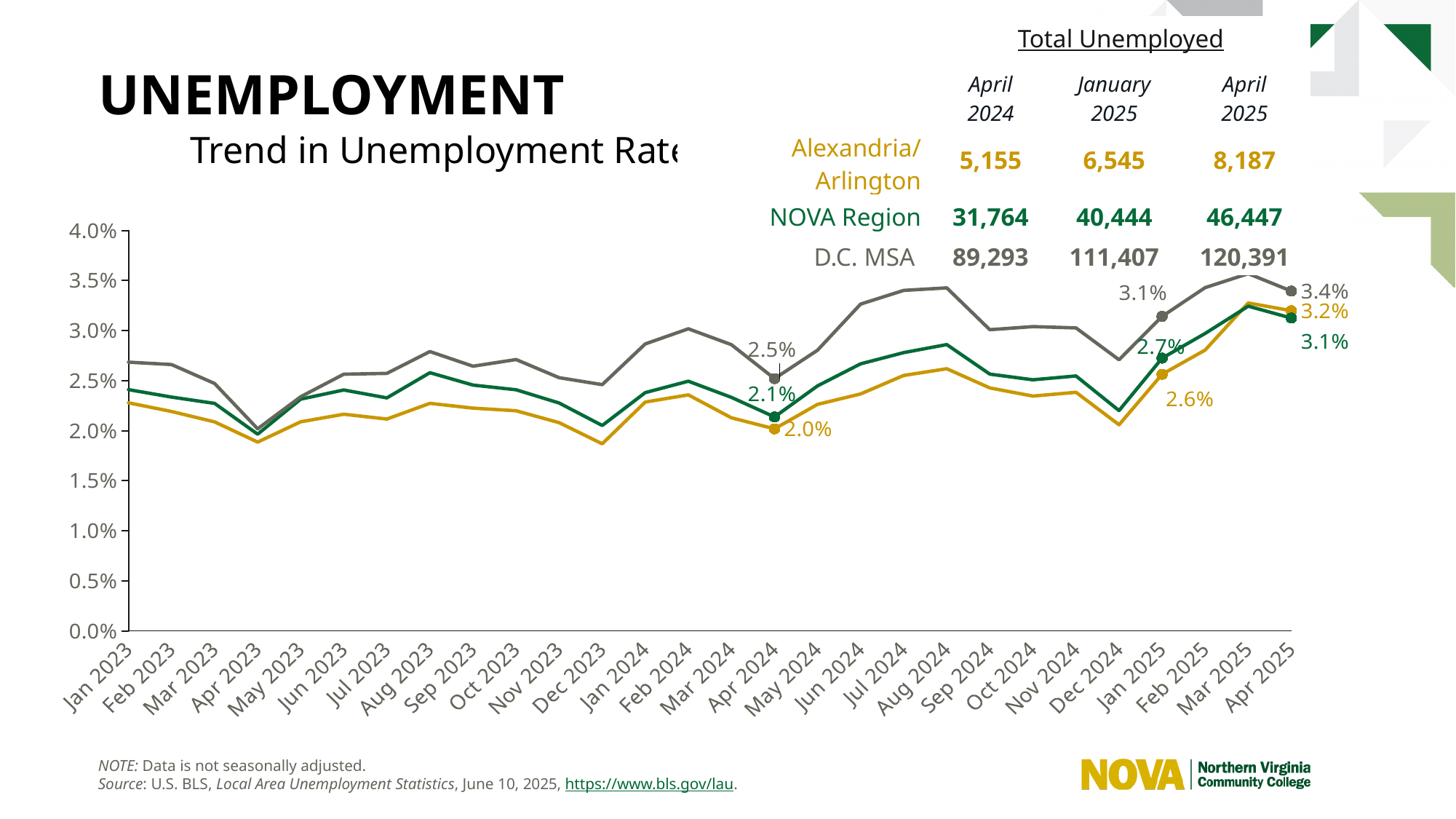
Which series had the highest unemployment rate in April 2025? D.C. MSA What was the D.C. MSA unemployment rate in April 2025? 3.4% Is the D.C. MSA unemployment rate in July 2024 greater or less than 3.0%? greater In April 2025, which was higher: the Alexandria/Arlington rate or the NOVA Region rate? Alexandria/Arlington What was the Alexandria/Arlington unemployment rate in April 2024? 2.0% Did the D.C. MSA unemployment rate rise or fall from April 2024 to April 2025? rise Which series had the lowest unemployment rate in April 2024? Alexandria/Arlington What was the NOVA Region unemployment rate in January 2025? 2.7% What was the Alexandria/Arlington unemployment rate in April 2025? 3.2% What type of chart is shown on the slide? line chart What is the difference between the D.C. MSA rate and the NOVA Region rate in April 2025? 0.3 percentage points How many months are plotted along the x axis? 28